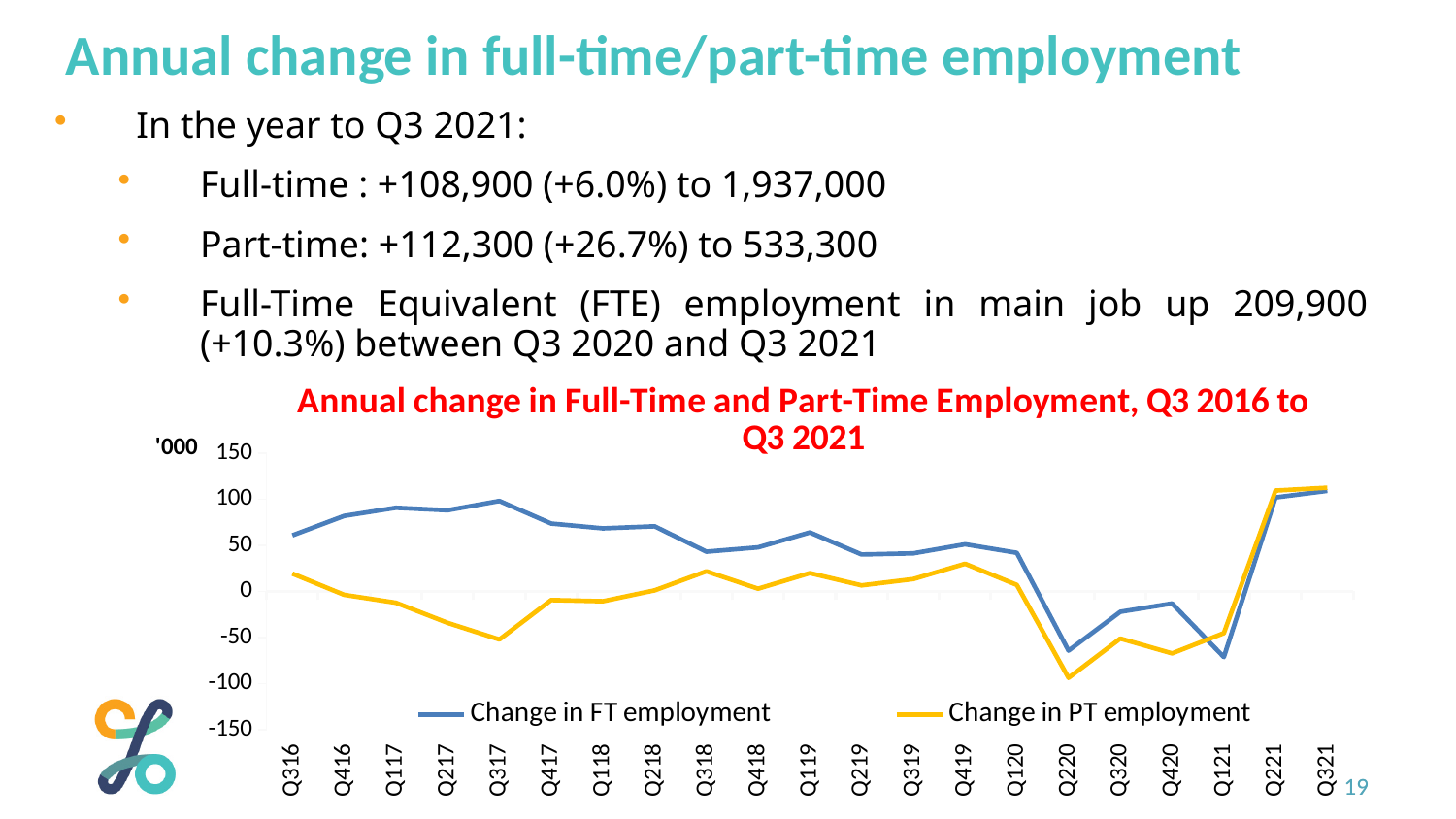
What kind of chart is shown on the slide? Line chart How many quarters are plotted along the x axis of the chart? 21 At Q220, which is larger: Change in FT employment or Change in PT employment? Change in FT employment Is the value for Change in PT employment at Q321 greater or less than 100? greater In which quarter is the Change in PT employment at its lowest? Q220 How many series does the chart legend list? 2 In which quarter is the Change in PT employment at its highest? Q321 What is the title of the chart? Annual change in Full-Time and Part-Time Employment, Q3 2016 to Q3 2021 Is the value for Change in FT employment at Q121 greater or less than -50? less Is the value for Change in FT employment at Q316 greater or less than 50? greater Which colour is used for the 'Change in PT employment' line? Yellow